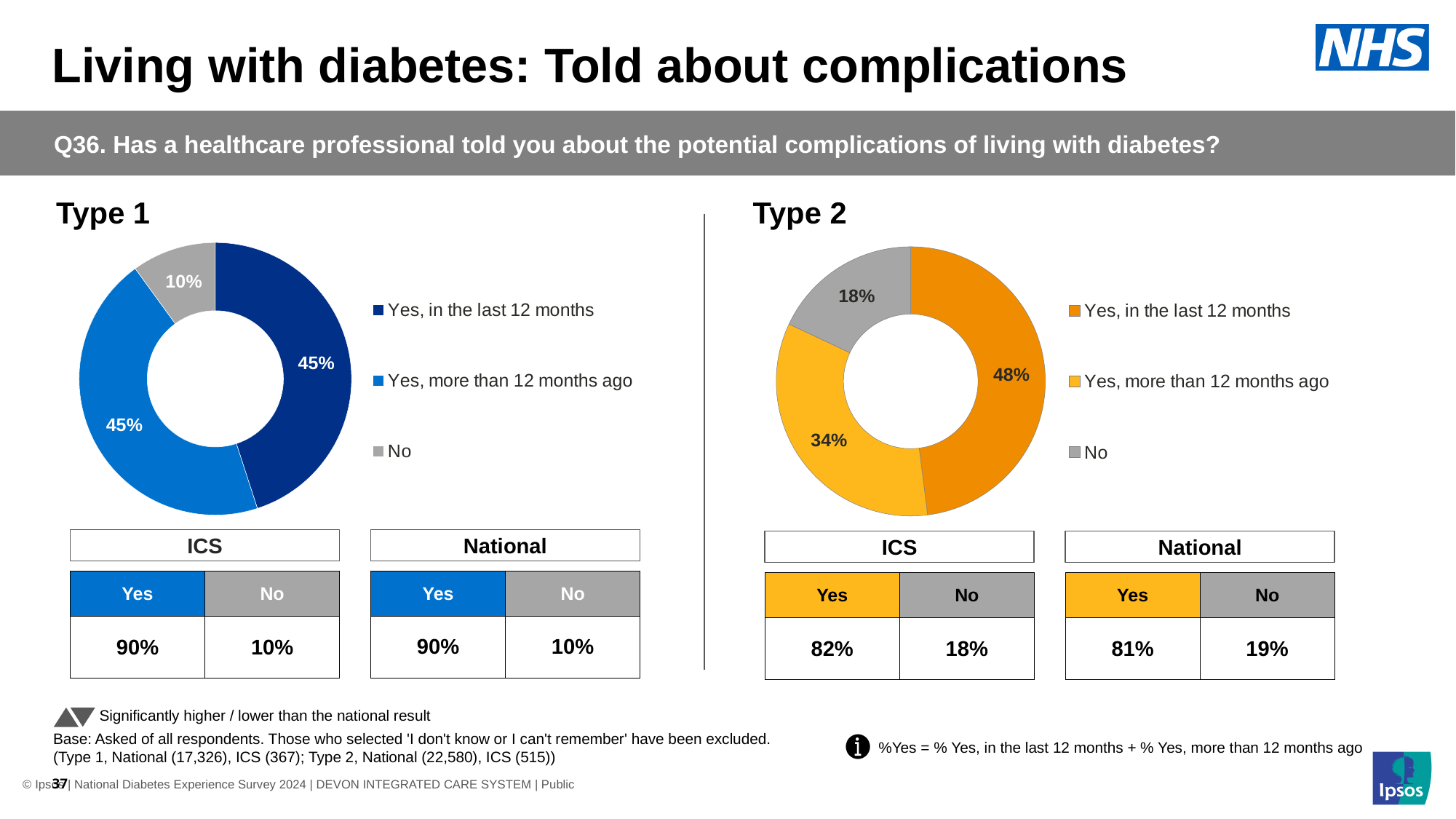
How many categories does the Type 1 chart show? 3 In the Type 1 chart, which category has the smallest share? No In the Type 1 chart, what colour represents 'No'? Grey In the Type 2 chart, which category has the smallest share? No In the Type 1 chart, what share of respondents answered 'Yes, more than 12 months ago'? 45% In the Type 2 chart, what share of respondents answered 'Yes, more than 12 months ago'? 34% In the Type 2 chart, what share of respondents answered 'Yes, in the last 12 months'? 48% In the Type 2 chart, what is the difference between the 'Yes, in the last 12 months' share and the 'Yes, more than 12 months ago' share? 14 percentage points What kind of chart is used for Type 2? Donut (pie) chart Which is larger: the 'No' share in the Type 1 chart or the 'No' share in the Type 2 chart? Type 2 In the Type 2 chart, which category has the largest share? Yes, in the last 12 months In the Type 1 chart, what share of respondents answered 'No'? 10%